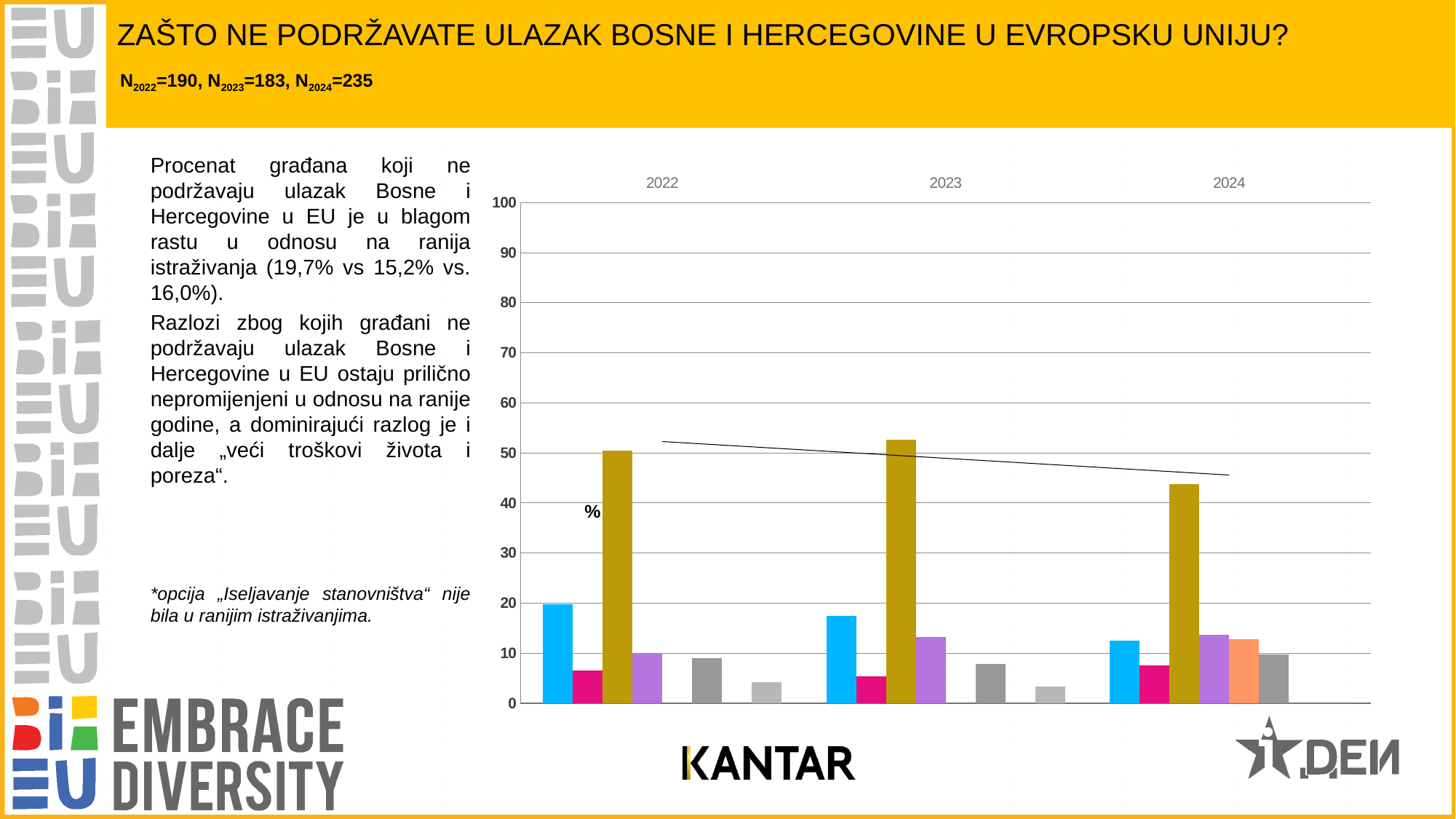
Which years are shown along the x axis of the chart? 2022, 2023, 2024 In the 2022 group, is the blue bar or the red bar larger? blue How many year groups are shown on the x axis of the chart? 3 In which year group is the gold bar the lowest? 2024 What kind of chart is shown on the slide? bar chart What is the highest value shown on the y axis of the chart? 100 Is the value of the blue bar in the 2022 group greater or less than 30? less Is the gold bar larger in the 2022 group or in the 2024 group? 2022 Does the blue bar rise or fall from 2022 to 2024? fall Is the value of the tallest (gold) bar in the 2022 group greater or less than 40? greater Is the value of the blue bar in the 2024 group greater or less than 10? greater